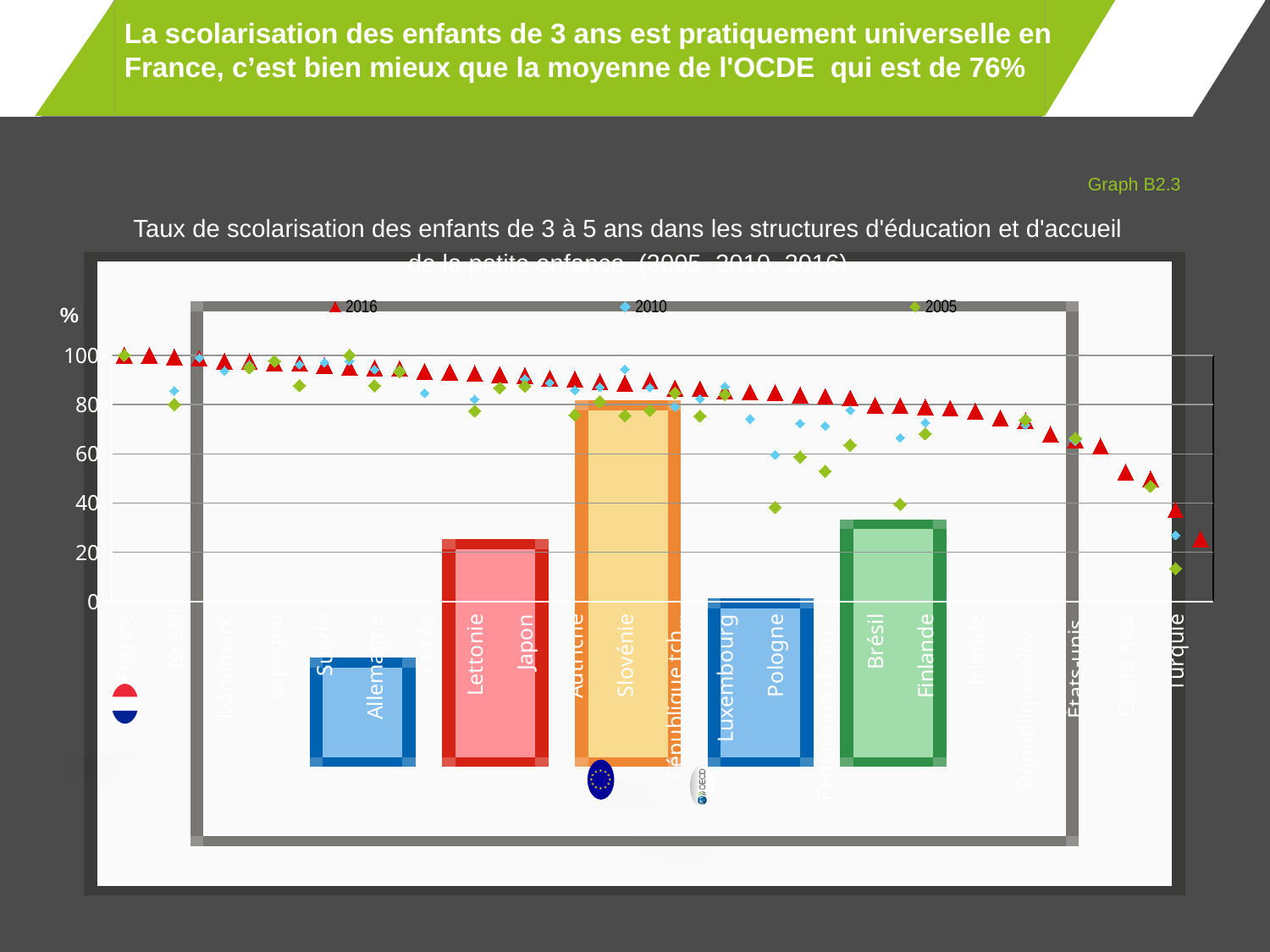
Is the 2005 value for Pologne greater or less than 60? less Which country has the lowest 2005 value in the chart? Turquie Is the 2016 value for Turquie greater or less than 60? less What marker shape and colour represents the 2016 series? Red triangles Is the 2005 value for Turquie greater or less than 20? less How many series does the chart legend list? 3 Which is larger for Pologne: the 2010 value or the 2005 value? 2010 Which is larger in 2016: Luxembourg or Turquie? Luxembourg Do the 2016 values rise or fall moving from left to right along the x axis? Fall Which years are shown as series in the chart legend? 2016, 2010, 2005